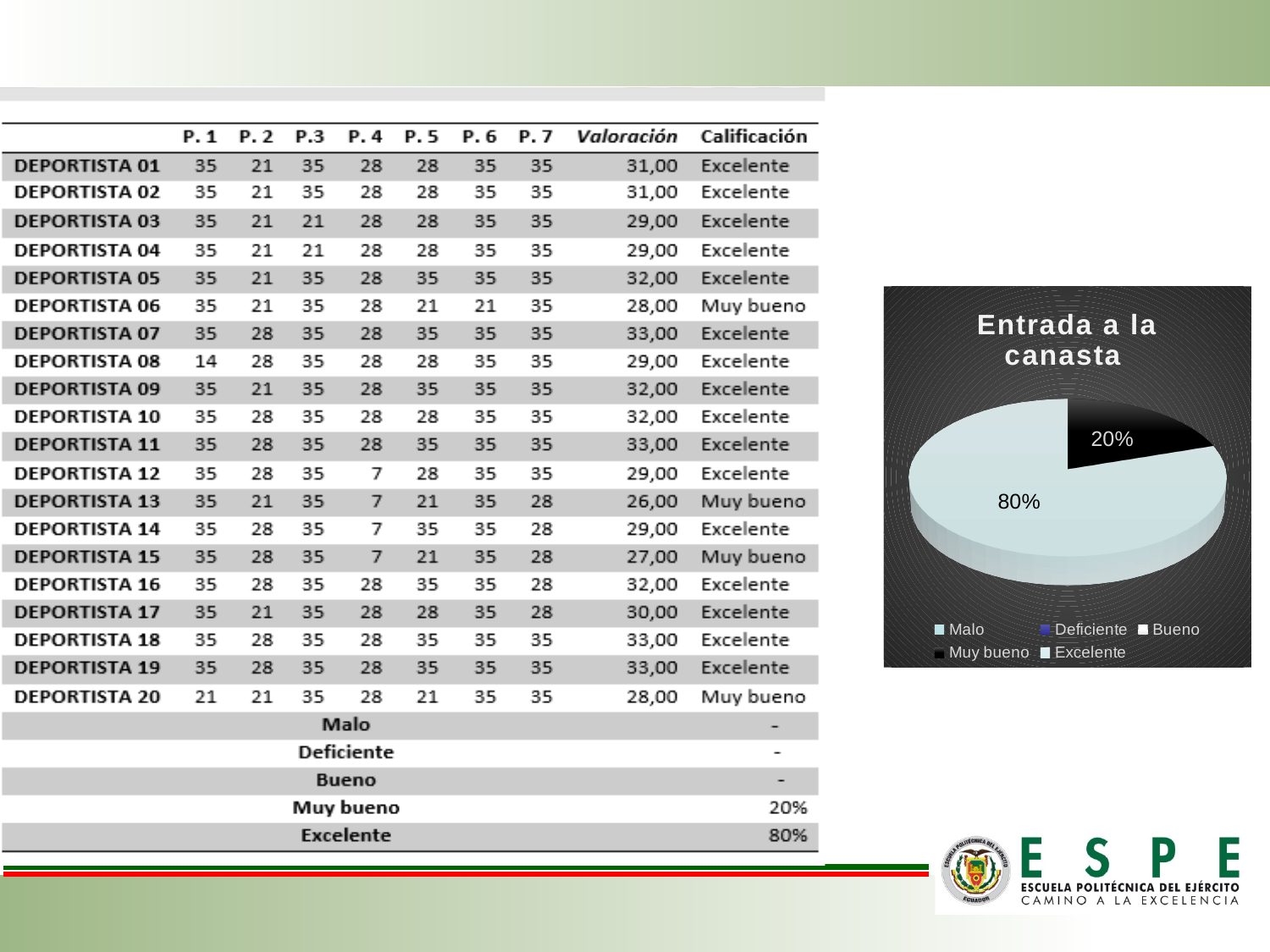
What percentage of the pie chart corresponds to Excelente? 80% Which of the two visible slices in the pie chart is the smallest? Muy bueno How many categories does the legend of the pie chart list? 5 What percentage of the pie chart corresponds to Muy bueno? 20% How many slices with a visible percentage label does the pie chart show? 2 Which slice is larger in the pie chart, Excelente or Muy bueno? Excelente What is the difference in percentage points between the Excelente slice and the Muy bueno slice? 60 percentage points What is the title of the pie chart? Entrada a la canasta What share of the pie does the black slice represent? 20% Which category has the largest slice in the pie chart? Excelente Which legend entry is shown in black in the pie chart? Muy bueno What kind of chart is shown on the slide? pie chart